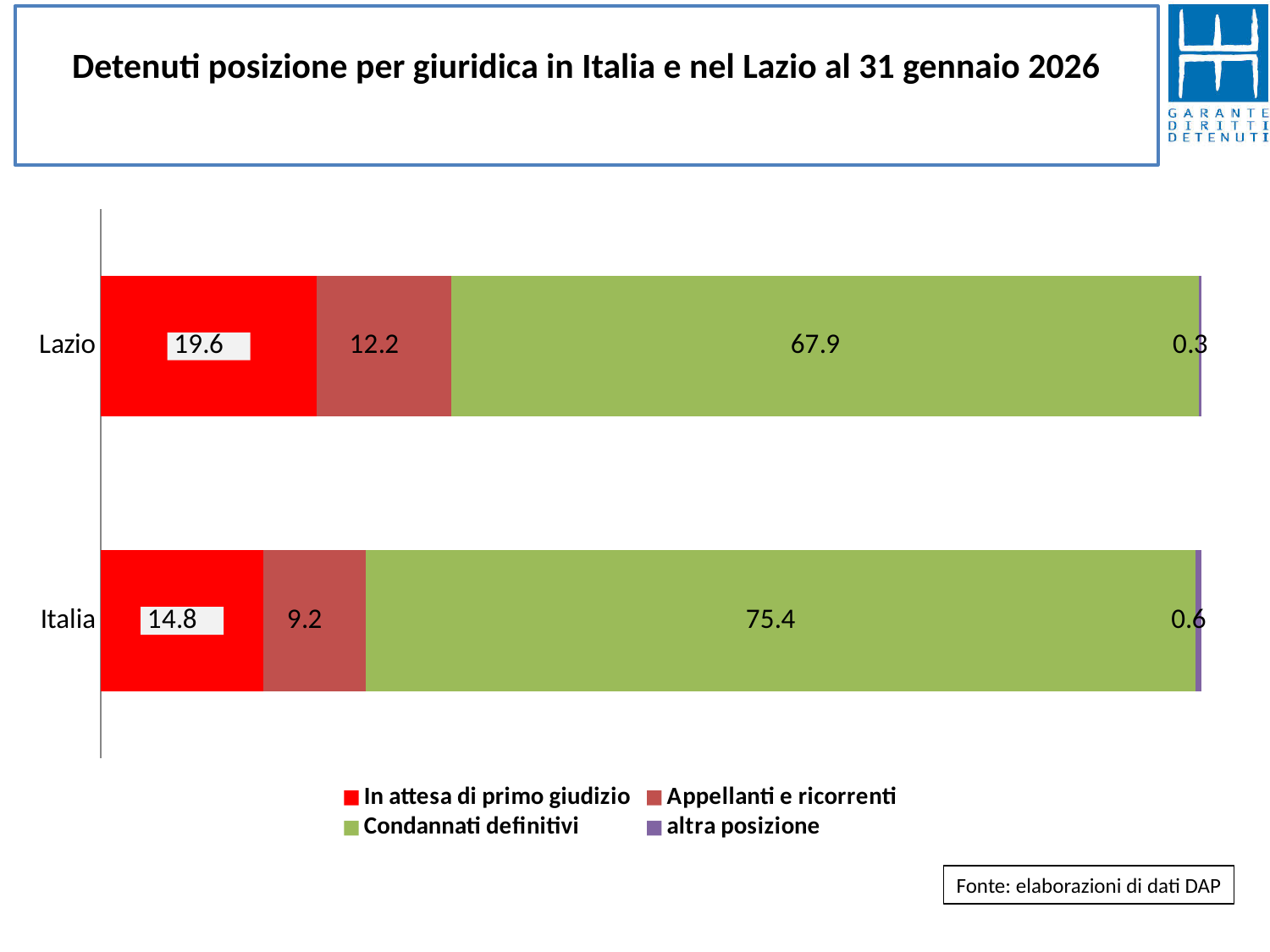
Which category has the higher value for 'In attesa di primo giudizio', Lazio or Italia? Lazio What kind of chart is shown on the slide? Stacked bar chart What is the difference between the 'Condannati definitivi' values for Italia and Lazio? 7.5 How many series does the legend list? 4 Which series has the smallest value in the Italia bar? altra posizione What is the difference between the 'Appellanti e ricorrenti' values for Lazio and Italia? 3.0 Which category has the higher value for 'Condannati definitivi', Lazio or Italia? Italia What is the value for 'In attesa di primo giudizio' for Lazio? 19.6 What is the value for 'Appellanti e ricorrenti' for Lazio? 12.2 What is the value for 'Condannati definitivi' for Italia? 75.4 Which series has the largest value in the Lazio bar? Condannati definitivi What is the value for 'altra posizione' for Italia? 0.6